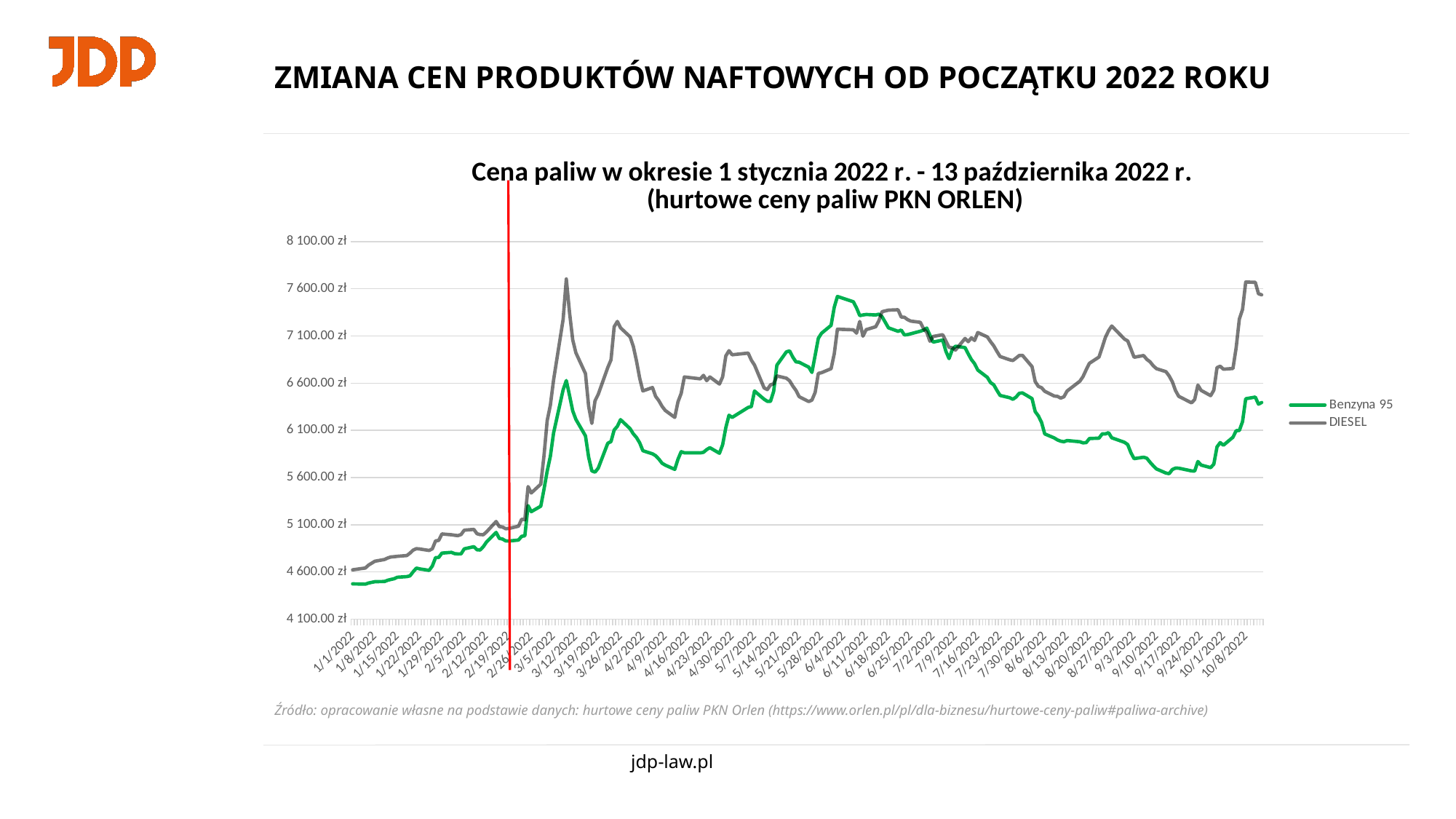
Which series is higher around 6/4/2022, Benzyna 95 or DIESEL? Benzyna 95 Which series reaches the highest value anywhere on the chart? DIESEL Which series is higher on 10/8/2022, Benzyna 95 or DIESEL? DIESEL Which two series are listed in the chart legend? Benzyna 95 and DIESEL Do the Benzyna 95 values rise or fall between 6/4/2022 and 9/10/2022? fall What colour is the Benzyna 95 line? green How many series does the legend list? 2 Is the peak value of DIESEL around 3/12/2022 greater or less than 7 600.00 zł? greater Is the value for Benzyna 95 on 1/1/2022 greater or less than 4 600.00 zł? less Is the peak value of Benzyna 95 around 6/4/2022 greater or less than 7 100.00 zł? greater What kind of chart is shown on the slide? line chart